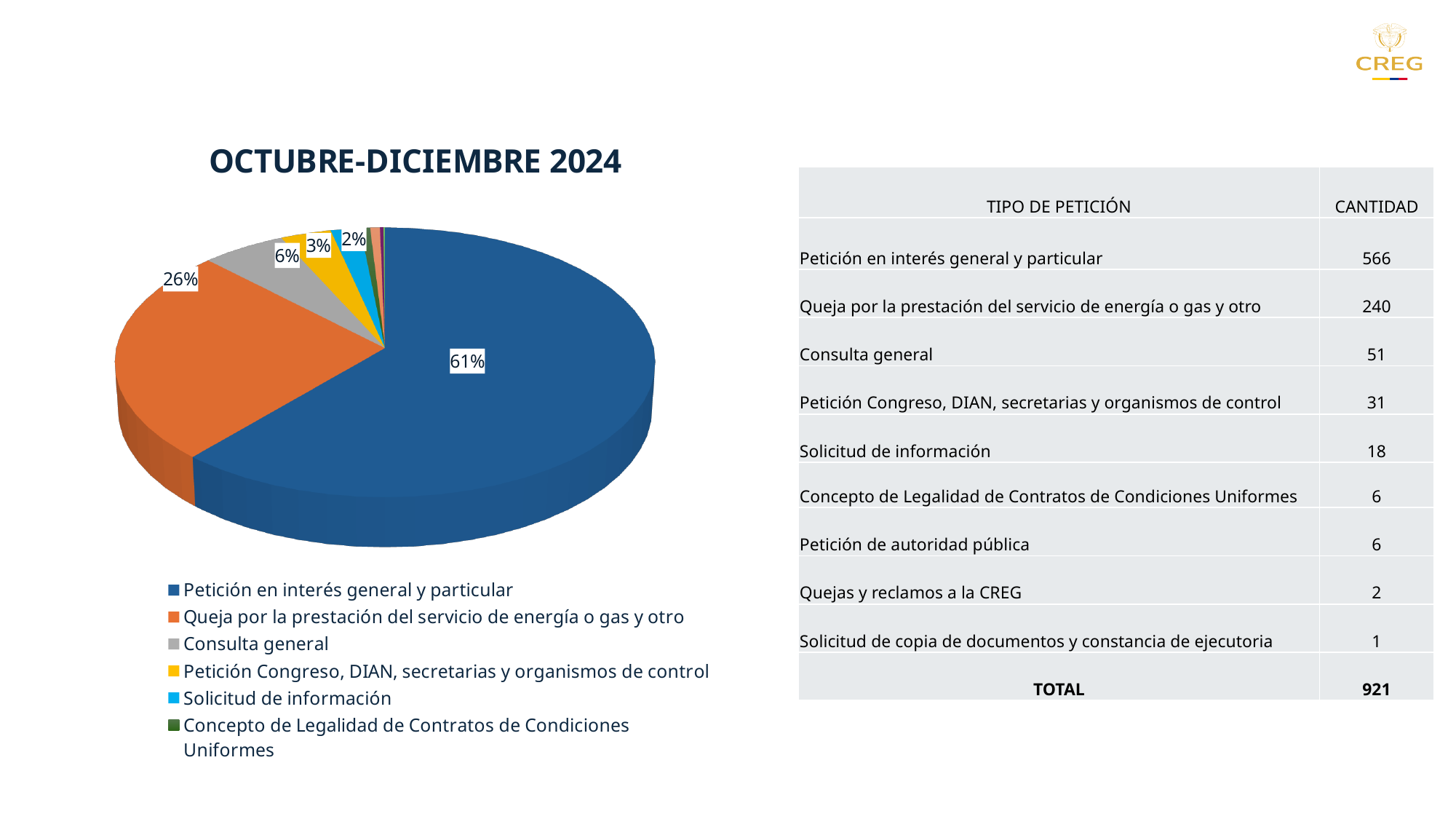
What share of the pie does "Solicitud de información" represent? 2% What is the difference in percentage points between the "Petición en interés general y particular" slice and the "Queja por la prestación del servicio de energía o gas y otro" slice? 35% Which slice is larger: "Consulta general" or "Petición Congreso, DIAN, secretarias y organismos de control"? Consulta general What colour is the slice for "Queja por la prestación del servicio de energía o gas y otro"? orange How many entries does the legend of the pie chart list? 6 What share of the pie does "Consulta general" represent? 6% What kind of chart is shown on the slide? pie chart What share of the pie does "Petición en interés general y particular" represent? 61% What is the title of the pie chart? OCTUBRE-DICIEMBRE 2024 Which category has the largest slice of the pie? Petición en interés general y particular